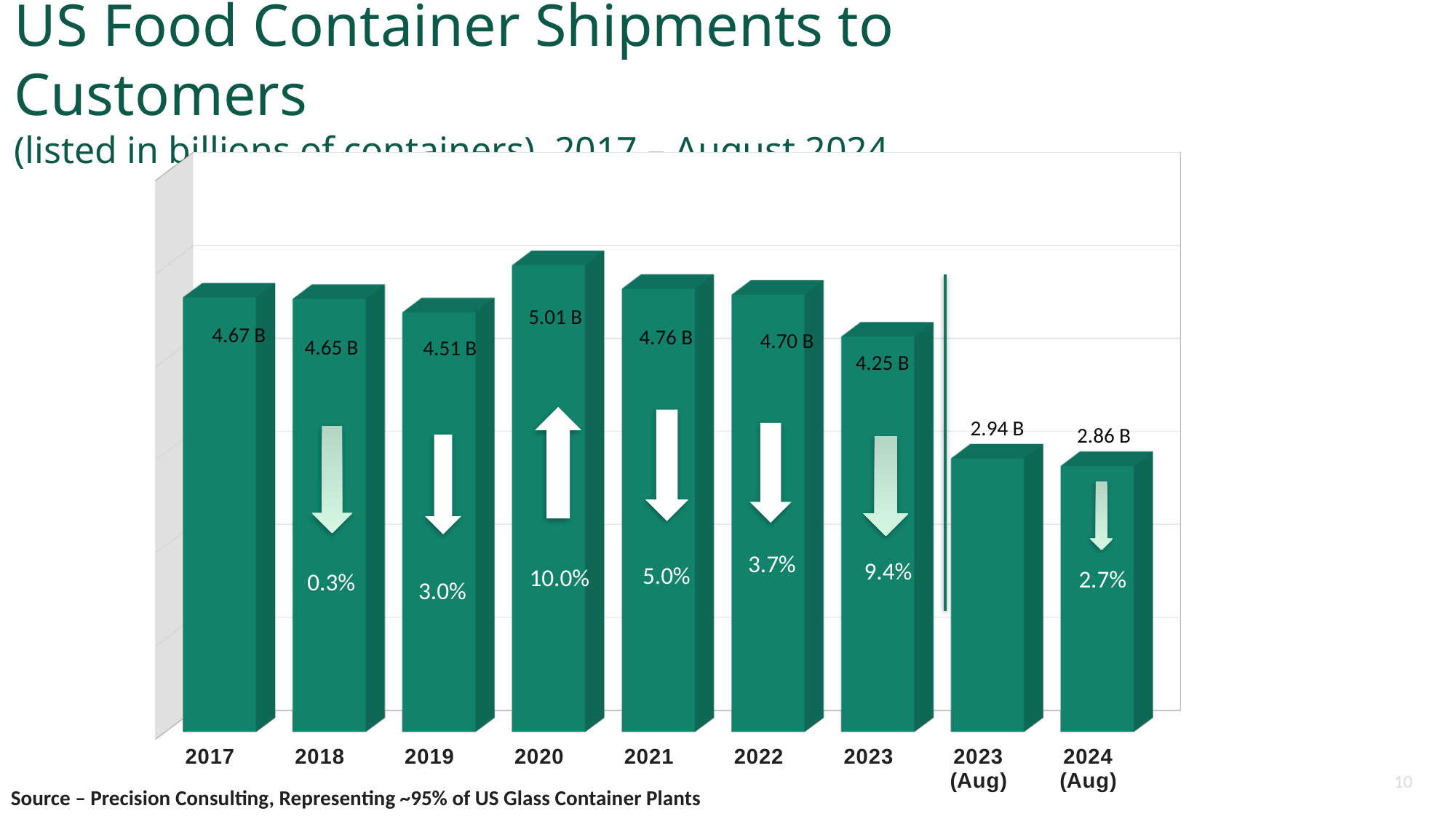
How many categories are shown on the x axis? 9 Do the values rise or fall from 2020 to 2023? fall What is the value for 2017? 4.67 B What is the value for 2023 (Aug)? 2.94 B What percentage change is shown on the 2023 bar? 9.4% What is the difference between the values for 2022 and 2023? 0.45 B What is the value for 2020? 5.01 B What kind of chart is this? bar chart Which category has the lowest value? 2024 (Aug) Which is larger, the value for 2021 or the value for 2022? 2021 Which year has the highest value? 2020 What is the difference between the values for 2020 and 2019? 0.50 B